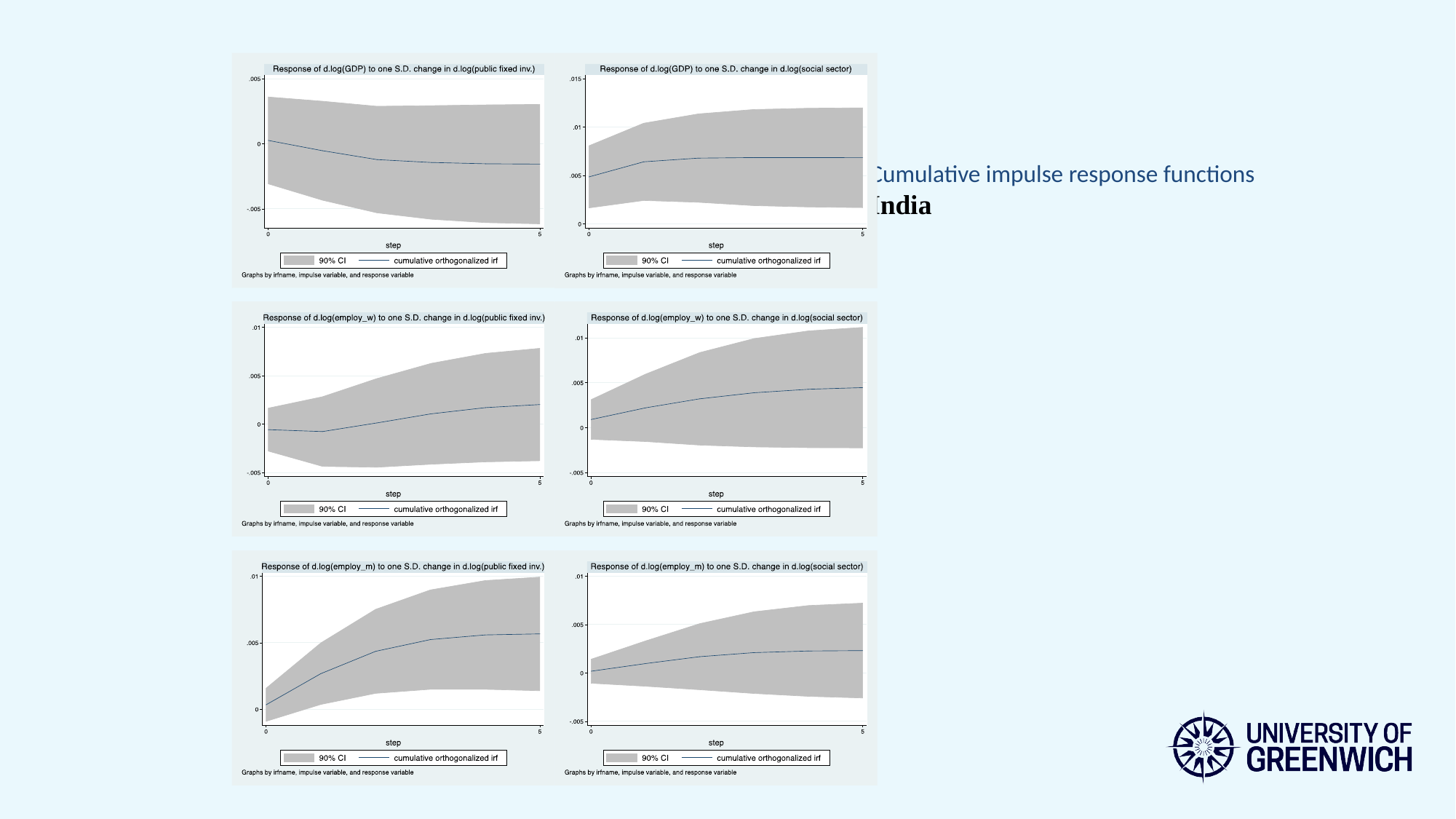
What is the x-axis label on the bottom-left chart (Response of d.log(employ_m) to d.log(public fixed inv.))? step What kind of chart is the top-left chart titled 'Response of d.log(GDP) to one S.D. change in d.log(public fixed inv.)'? Line chart In the top-right chart (Response of d.log(GDP) to d.log(social sector)), is the value of the cumulative orthogonalized irf at step 5 greater or less than .005? greater In the top-left chart (Response of d.log(GDP) to d.log(public fixed inv.)), is the value of the cumulative orthogonalized irf at step 5 greater or less than 0? less In the top-right chart (Response of d.log(GDP) to d.log(social sector)), what are the two legend entries? 90% CI and cumulative orthogonalized irf In the bottom-left chart (Response of d.log(employ_m) to d.log(public fixed inv.)), does the cumulative orthogonalized irf line rise or fall from step 0 to step 5? Rise How many charts are shown on the slide? 6 In the middle-left chart (Response of d.log(employ_w) to d.log(public fixed inv.)), is the value of the cumulative orthogonalized irf at step 5 greater or less than .005? less In the top-left chart (Response of d.log(GDP) to d.log(public fixed inv.)), does the cumulative orthogonalized irf line rise or fall from step 0 to step 5? Fall In the top-right chart (Response of d.log(GDP) to d.log(social sector)), does the cumulative orthogonalized irf line rise or fall from step 0 to step 5? Rise In the top-left chart (Response of d.log(GDP) to d.log(public fixed inv.)), how many entries does the legend list? 2